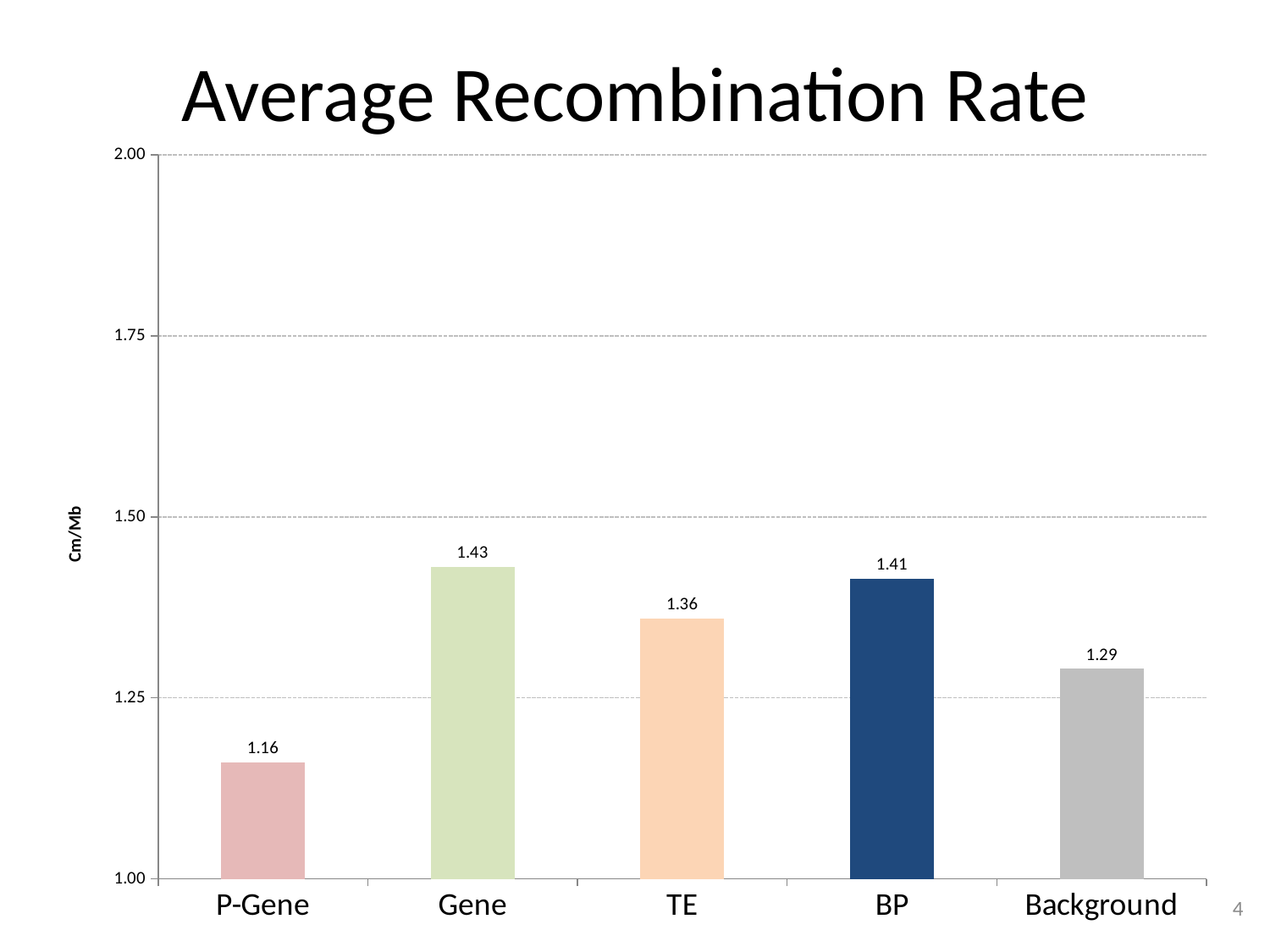
What is the average recombination rate for P-Gene? 1.16 What is the difference between the values for TE and Background? 0.07 Is the value for Background greater or less than 1.25? greater What is the difference between the values for Gene and P-Gene? 0.27 How many categories are shown on the x axis? 5 What is the label on the vertical axis? Cm/Mb Which is larger, the value for TE or the value for BP? BP What kind of chart is shown on the slide? bar chart Which category has the highest average recombination rate? Gene What is the value shown for BP? 1.41 What is the value shown for Background? 1.29 Which category has the lowest average recombination rate? P-Gene